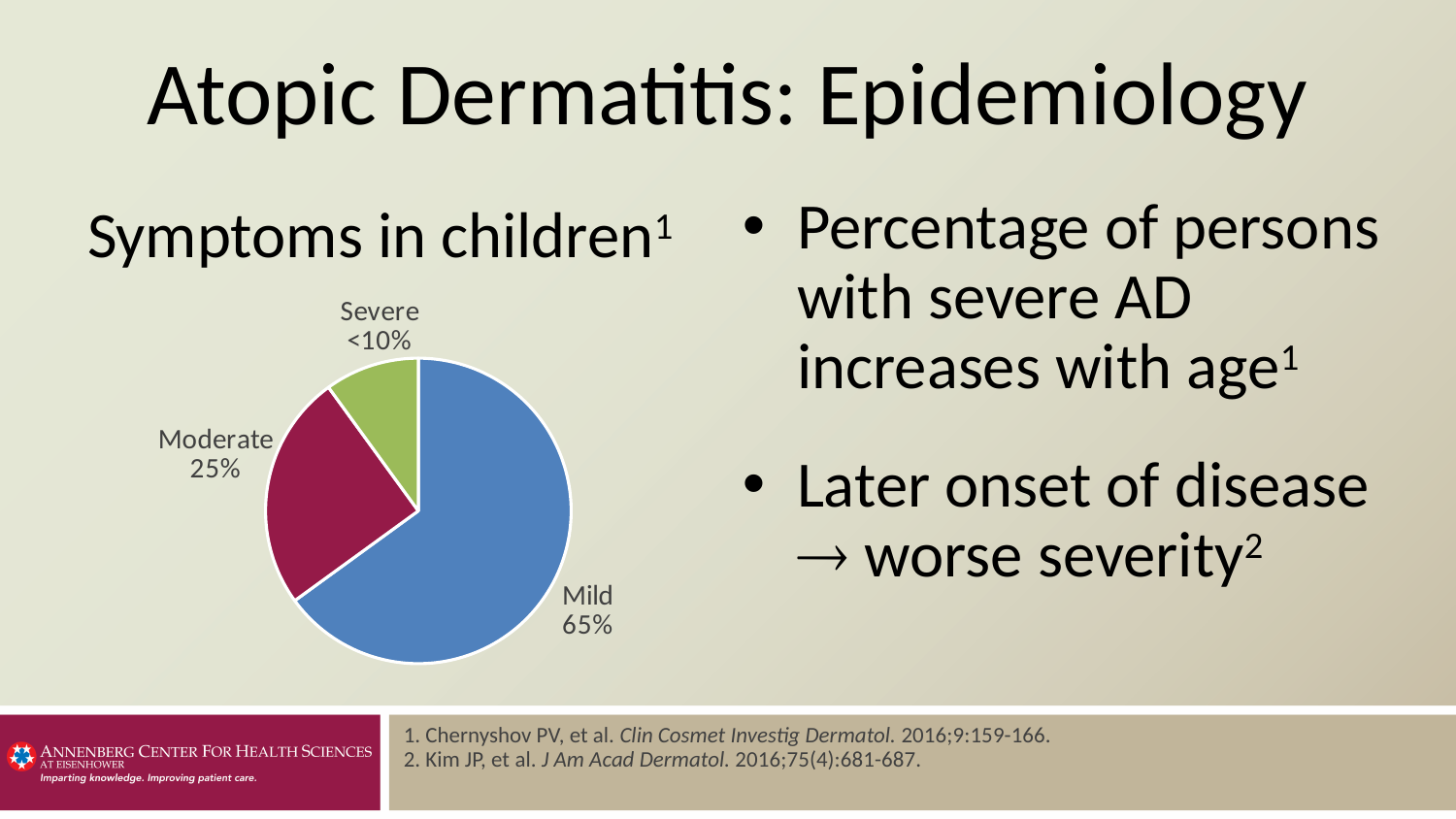
Which symptom category has the largest share of the pie chart? Mild What type of chart is shown on the slide? pie chart What colour is the Mild slice in the pie chart? blue What percentage of children have moderate symptoms according to the pie chart? 25% What is the title of the chart? Symptoms in children What share of the pie does the Mild slice represent? 65% How many slices does the pie chart have? 3 What percentage of children have mild symptoms according to the pie chart? 65% Which is larger in the pie chart, the Moderate slice or the Severe slice? Moderate Which symptom category has the smallest share of the pie chart? Severe What value is shown for the Severe slice of the pie chart? <10% By how many percentage points does the Mild share exceed the Moderate share? 40 percentage points